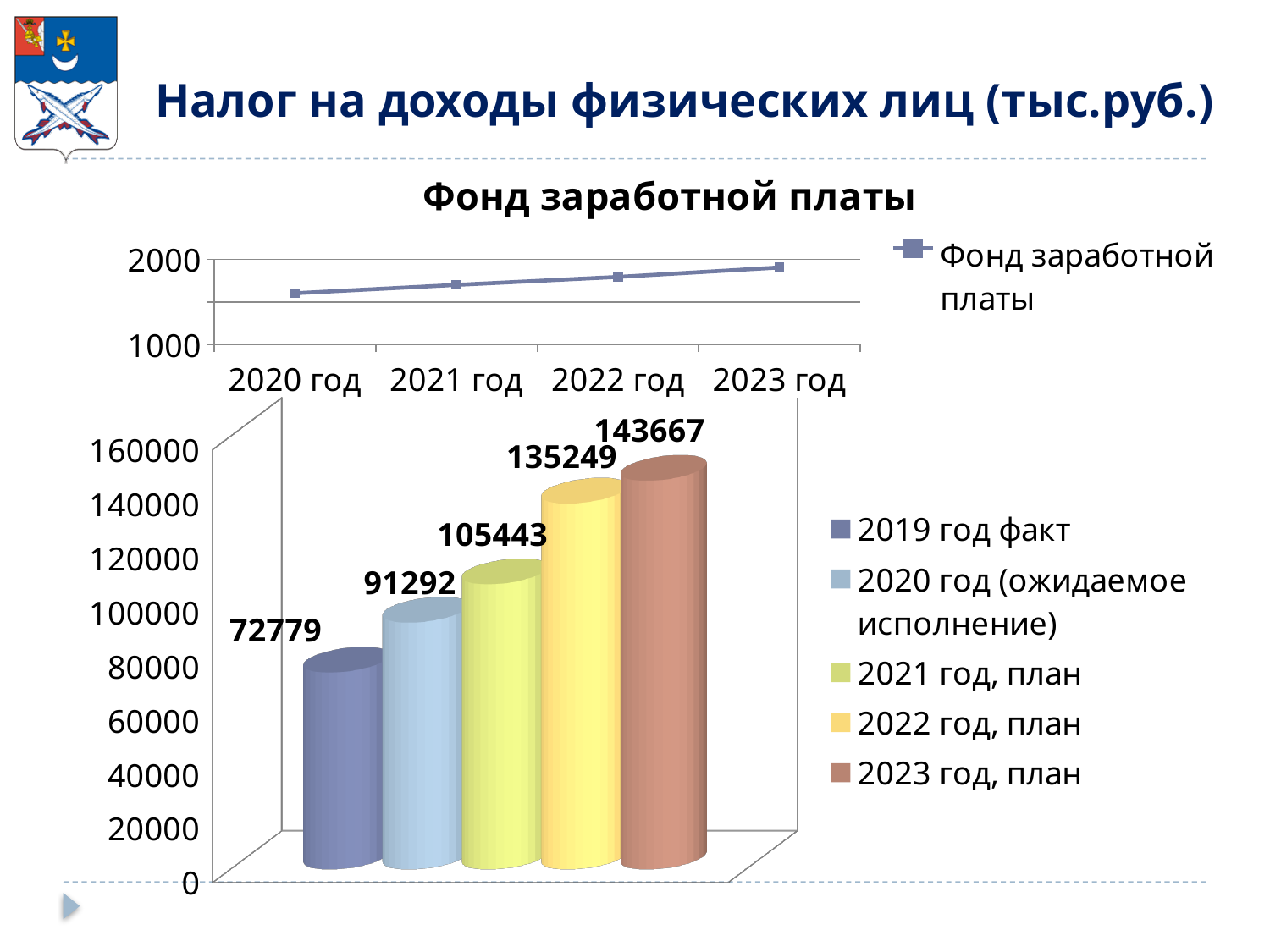
On the bottom bar chart, which series has the lowest value? 2019 год факт On the bottom bar chart, what is the difference between the values for 2023 год, план and 2022 год, план? 8418 On the bottom bar chart, what is the value for 2019 год факт? 72779 On the bottom bar chart, what is the value for 2022 год, план? 135249 On the bottom bar chart, what is the difference between the values for 2021 год, план and 2019 год факт? 32664 On the bottom bar chart, what is the value for 2020 год (ожидаемое исполнение)? 91292 On the chart titled Фонд заработной платы, is the value for 2020 год greater or less than 2000? less On the bottom bar chart, which is larger: the value for 2021 год, план or the value for 2020 год (ожидаемое исполнение)? 2021 год, план On the chart titled Фонд заработной платы, do the values rise or fall from 2020 год to 2023 год? rise How many series does the legend of the bottom bar chart list? 5 On the bottom bar chart, which series has the highest value? 2023 год, план What kind of chart is the chart titled Фонд заработной платы? line chart